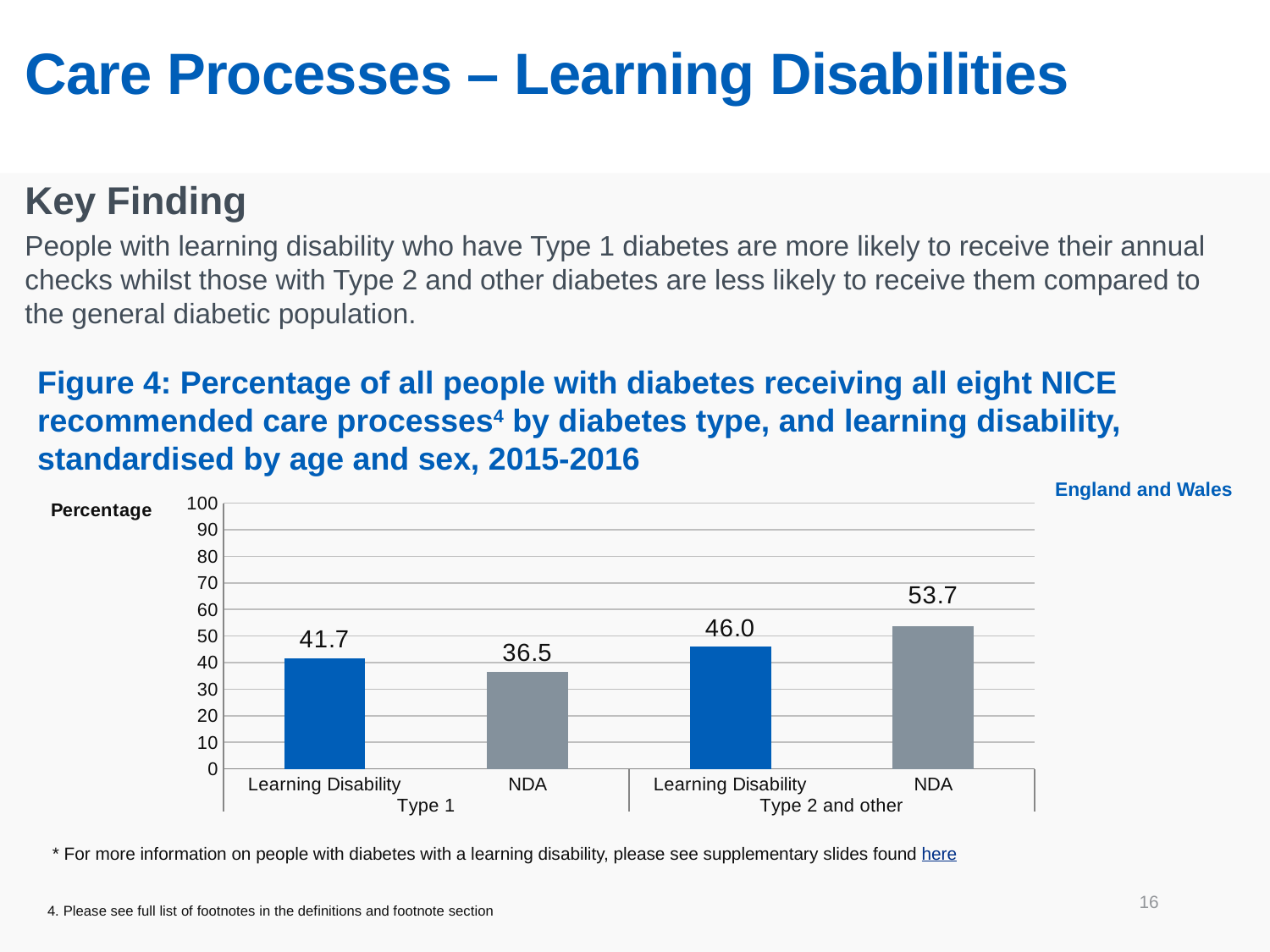
What is the value for Learning Disability in the Type 1 group? 41.7 Which bar has the highest value? NDA, Type 2 and other What is the value for NDA in the Type 1 group? 36.5 What is the value for Learning Disability in the Type 2 and other group? 46.0 What is the label on the vertical axis of the chart? Percentage What is the difference between the NDA and Learning Disability values in the Type 2 and other group? 7.7 What is the difference between the Learning Disability and NDA values in the Type 1 group? 5.2 Which bar has the lowest value? NDA, Type 1 What kind of chart is shown? Bar chart How many bars are plotted in the chart? 4 What is the value for NDA in the Type 2 and other group? 53.7 In the Type 2 and other group, which is larger: Learning Disability or NDA? NDA